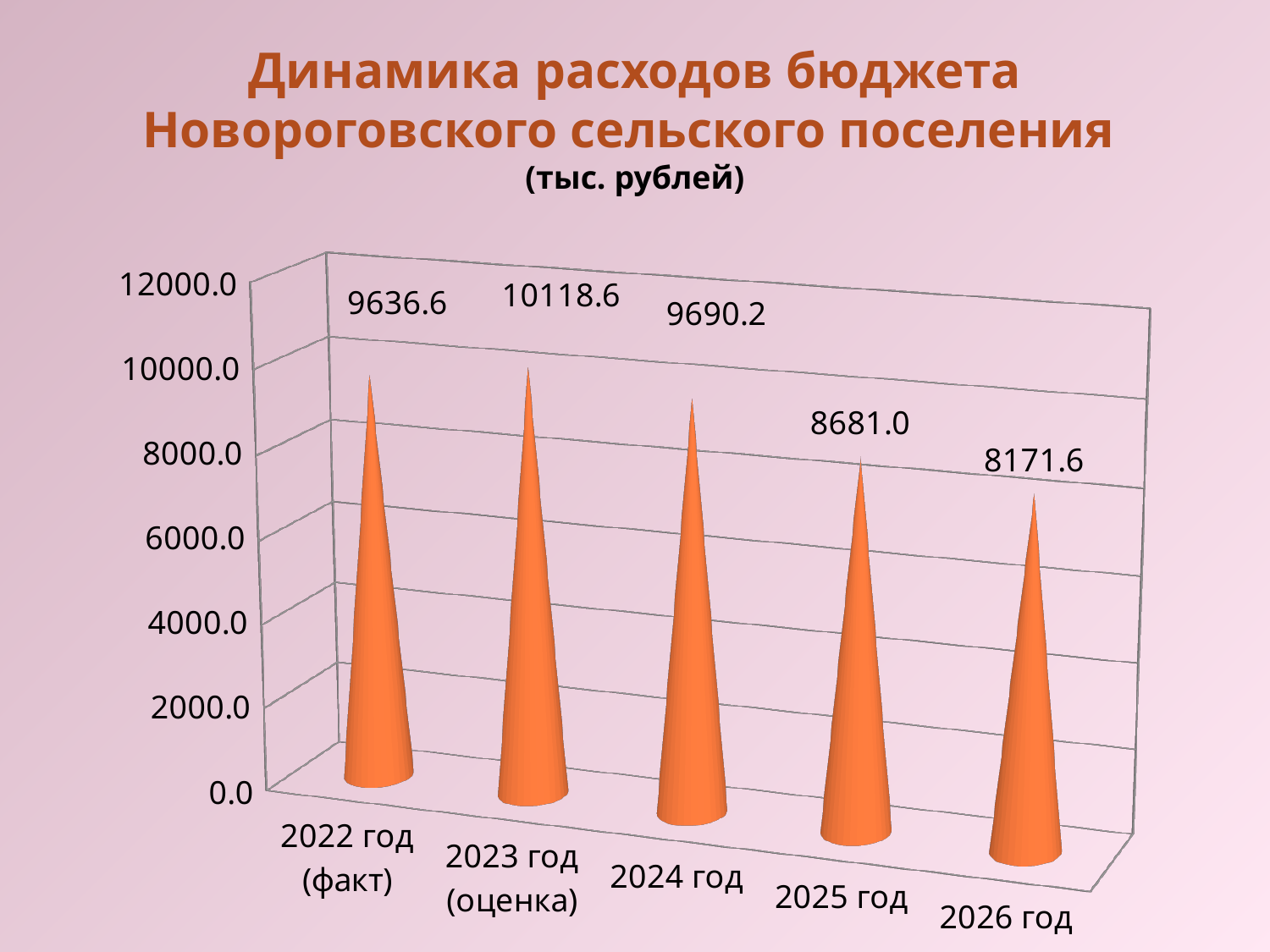
How many years are shown on the x axis? 5 Which year has the lowest value? 2026 год Which year has the highest value? 2023 год (оценка) What is the value for 2022 год (факт)? 9636.6 What is the value for 2023 год (оценка)? 10118.6 What kind of chart is this? bar chart Which is larger, the value for 2024 год or the value for 2025 год? 2024 год What is the value for 2026 год? 8171.6 What is the value for 2025 год? 8681.0 What is the difference between the values for 2023 год (оценка) and 2022 год (факт)? 482.0 What is the difference between the values for 2025 год and 2026 год? 509.4 Do the values rise or fall from 2023 год (оценка) to 2026 год? fall